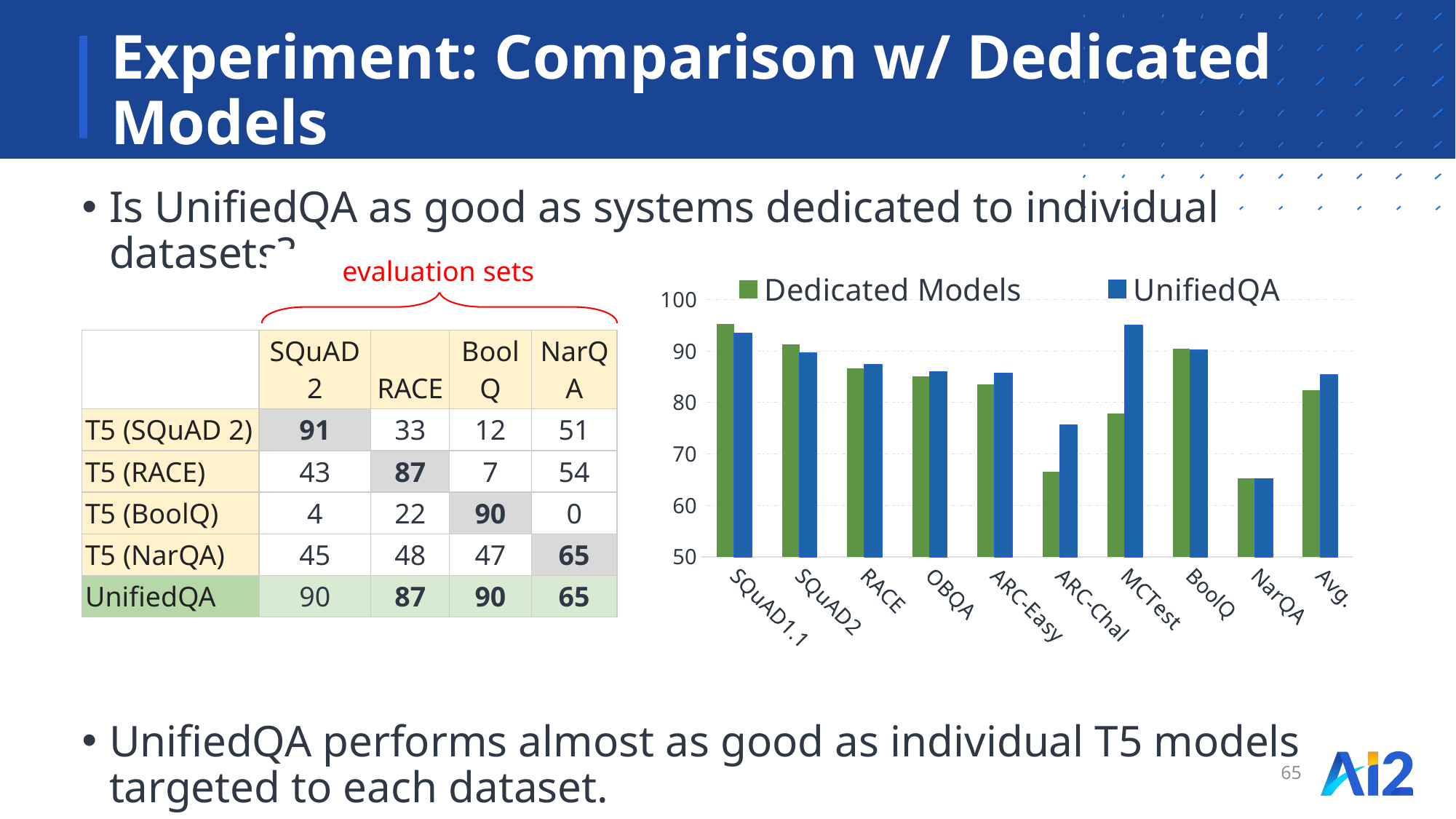
For which category is the Dedicated Models value highest? SQuAD1.1 How many categories are shown along the x axis of the chart? 10 Is the Dedicated Models value for MCTest greater or less than 80? less How many series does the chart's legend list? 2 What kind of chart is shown on the slide? bar chart Is the UnifiedQA value for MCTest greater or less than 90? greater For which category is the UnifiedQA value lowest? NarQA Is the Dedicated Models value for ARC-Chal greater or less than 70? less For ARC-Chal, which is larger: the Dedicated Models value or the UnifiedQA value? UnifiedQA Which series in the chart is drawn in blue? UnifiedQA Which series in the chart is drawn in green? Dedicated Models